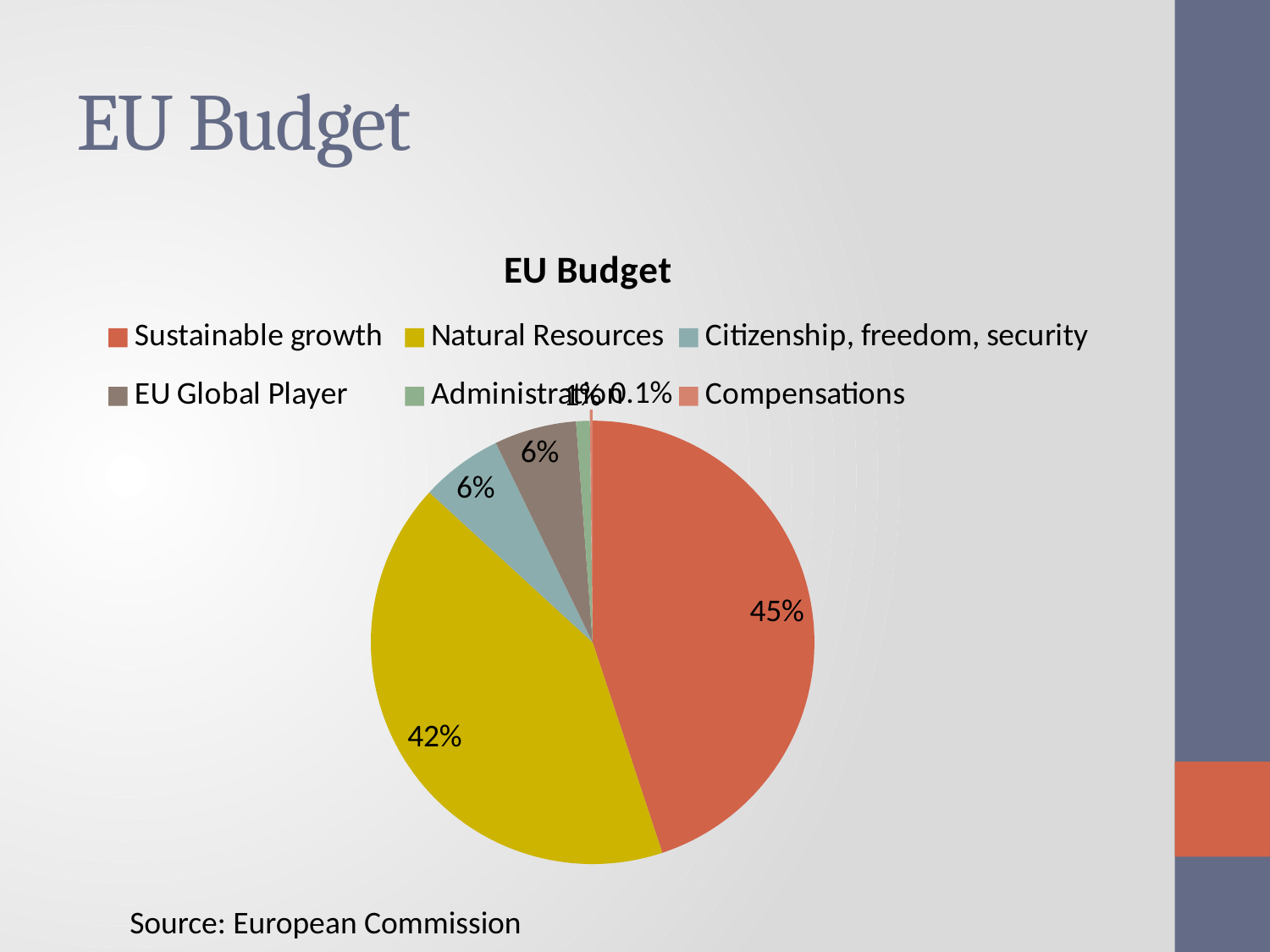
How many categories does the legend of the pie chart list? 6 How many percentage points larger is the Sustainable growth share than the Natural Resources share? 3% What share of the EU Budget goes to Compensations? 0.1% What colour is the Natural Resources slice of the pie chart? yellow What share of the EU Budget goes to Citizenship, freedom, security? 6% Which is larger, the share for Sustainable growth or the share for Natural Resources? Sustainable growth Which category has the smallest share of the EU Budget? Compensations Which category has the largest share of the EU Budget? Sustainable growth What share of the EU Budget goes to EU Global Player? 6% What share of the EU Budget goes to Sustainable growth? 45% What share of the EU Budget goes to Natural Resources? 42% What kind of chart is shown on the slide? pie chart